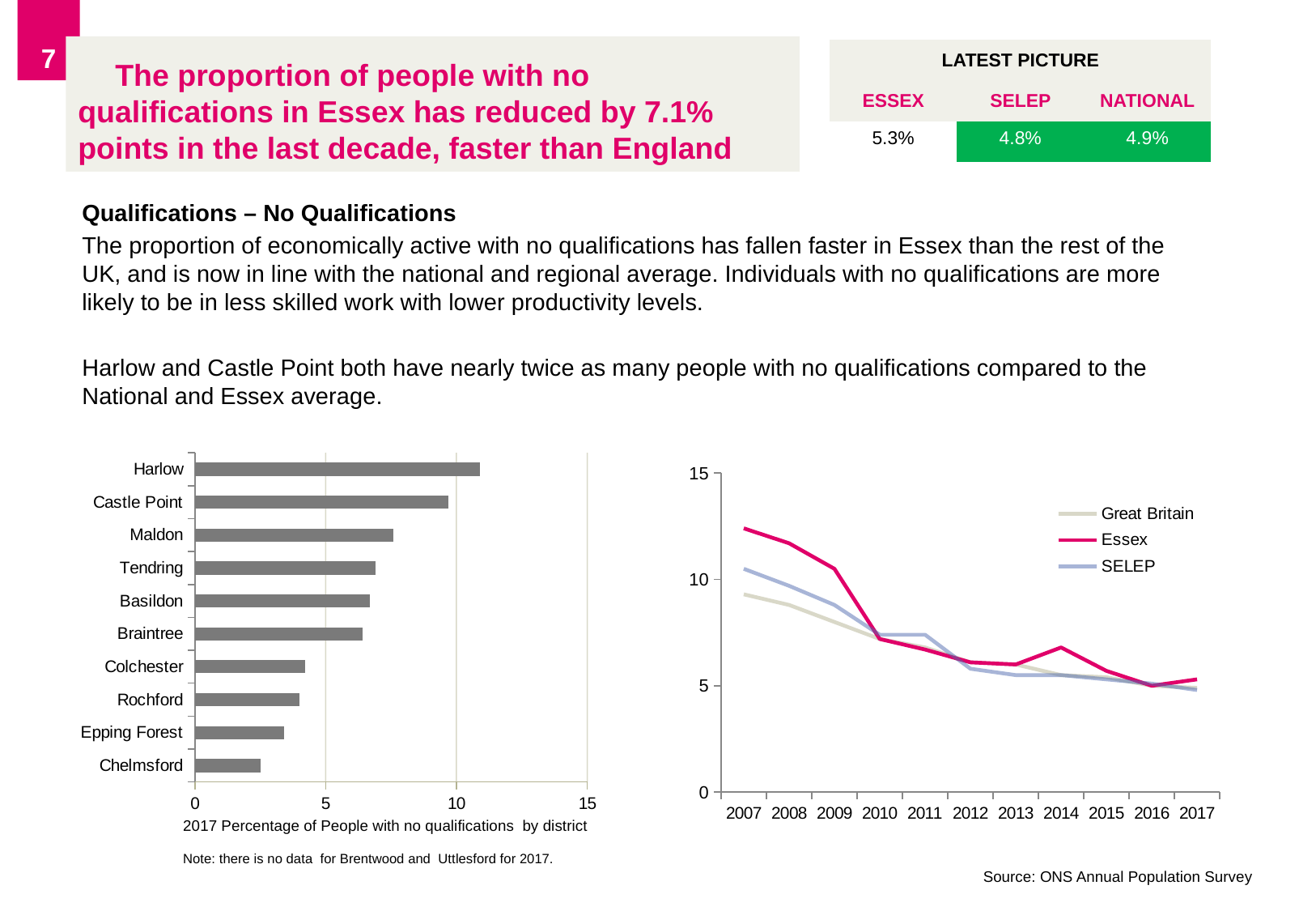
In the line chart on the right, which series has the highest value in 2007? Essex In the bar chart on the left, which is larger, the value for Maldon or the value for Tendring? Maldon In the bar chart on the left, is the value for Harlow greater or less than 10? greater How many districts are shown in the bar chart on the left? 10 What kind of chart is the chart on the right of the slide? line chart In the bar chart on the left, which district has the lowest percentage of people with no qualifications? Chelmsford In the bar chart on the left, which district has the highest percentage of people with no qualifications? Harlow How many series does the legend of the line chart on the right list? 3 In the bar chart on the left, is the value for Colchester greater or less than 5? less In the line chart on the right, does the Essex line rise or fall from 2007 to 2017? fall What kind of chart is the chart on the left of the slide? bar chart In the line chart on the right, is the Essex value for 2007 greater or less than 10? greater